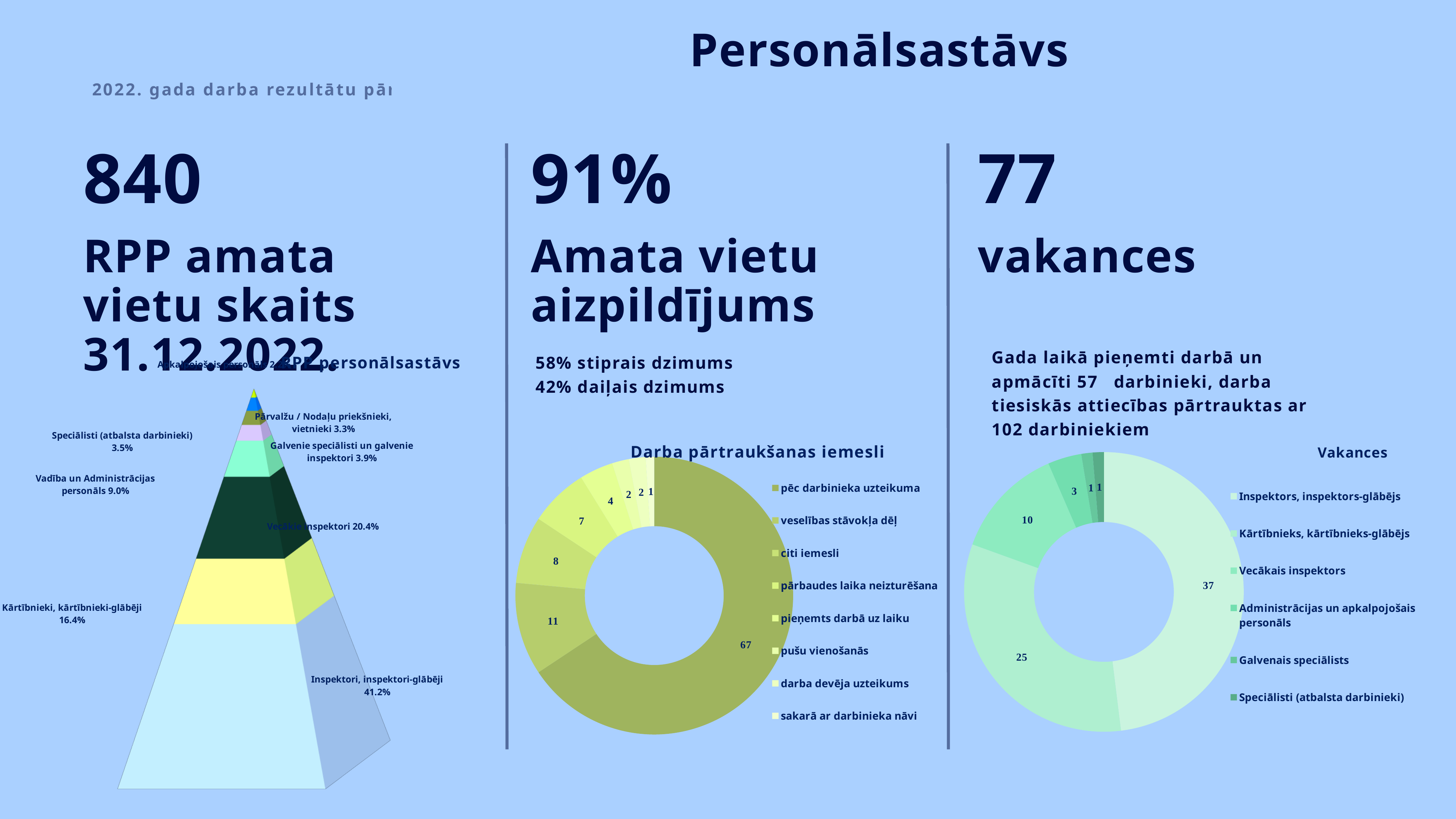
In the 'Vakances' chart, what is the value for 'Kārtībnieks, kārtībnieks-glābējs'? 25 In the 'RPP personālsastāvs' pyramid chart, which is larger: 'Vecākie inspektori' or 'Kārtībnieki, kārtībnieki-glābēji'? Vecākie inspektori In the 'Darba pārtraukšanas iemesli' chart, what is the value for 'pēc darbinieka uzteikuma'? 67 In the 'Darba pārtraukšanas iemesli' chart, what is the value for 'veselības stāvokļa dēļ'? 11 In the 'Vakances' chart, what is the difference between 'Inspektors, inspektors-glābējs' and 'Vecākais inspektors'? 27 In the 'Vakances' chart, which is larger: 'Vecākais inspektors' or 'Administrācijas un apkalpojošais personāls'? Vecākais inspektors How many categories does the legend of the 'Darba pārtraukšanas iemesli' chart list? 8 In the 'RPP personālsastāvs' pyramid chart, what is the share for 'Inspektori, inspektori-glābēji'? 41.2% In the 'Darba pārtraukšanas iemesli' chart, what is the difference between 'citi iemesli' and 'pārbaudes laika neizturēšana'? 1 In the 'Darba pārtraukšanas iemesli' chart, which reason has the lowest value? sakarā ar darbinieka nāvi What kind of chart is 'Darba pārtraukšanas iemesli'? Doughnut chart In the 'Vakances' chart, which category has the highest value? Inspektors, inspektors-glābējs